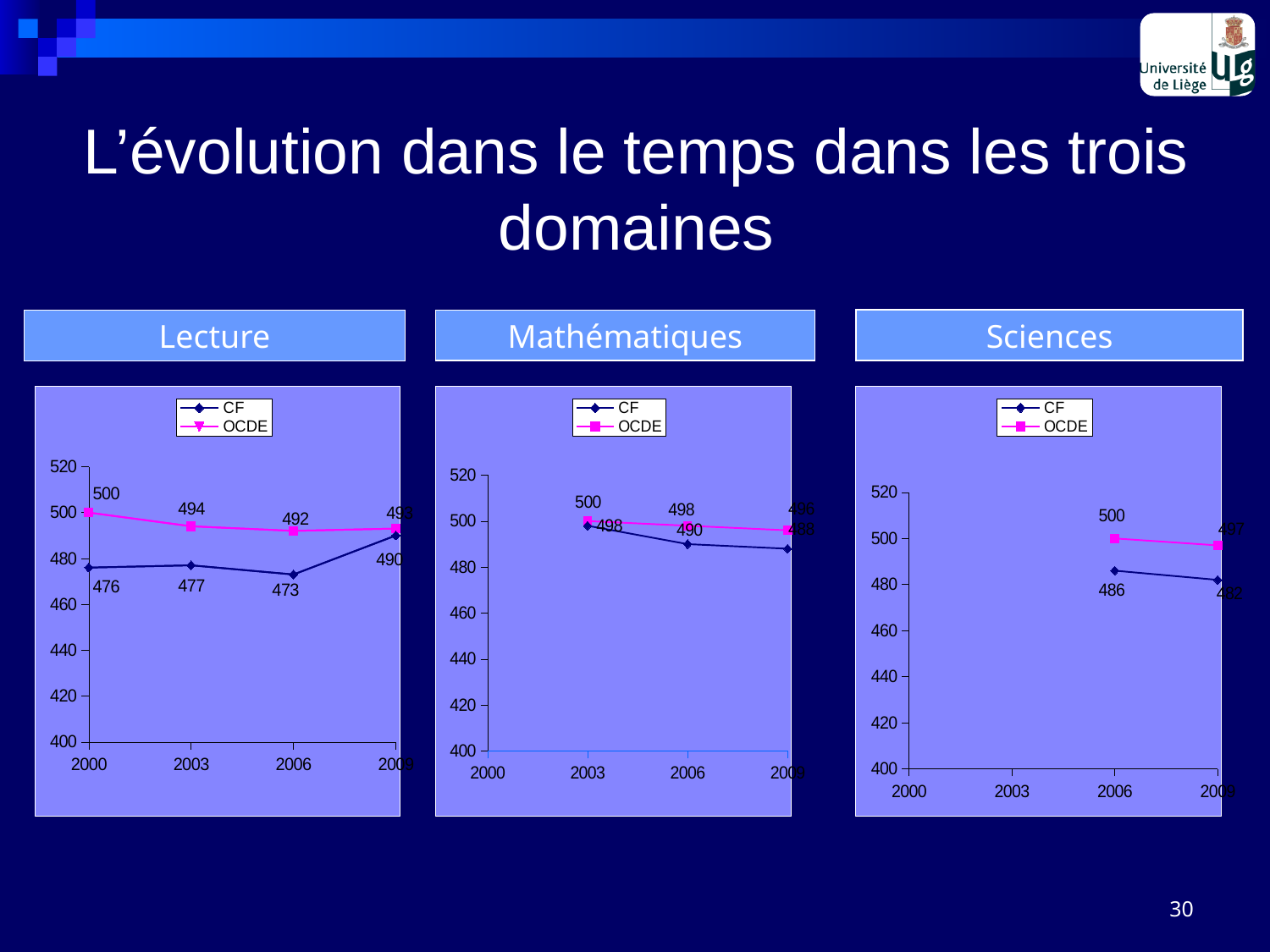
In the Mathématiques chart, what is the CF value for 2006? 490 In the Sciences chart, what is the CF value for 2006? 486 In the Lecture chart, does the CF value rise or fall between 2006 and 2009? rise In the Mathématiques chart, what is the difference between the OCDE and CF values in 2003? 2 In the Mathématiques chart, does the CF line rise or fall from 2003 to 2009? fall In the Lecture chart, in which year is the CF value lowest? 2006 In the Lecture chart, what is the difference between the OCDE and CF values in 2000? 24 In the Mathématiques chart, what is the OCDE value for 2003? 500 How many series does the legend of the Lecture chart list? 2 In the Lecture chart, what is the CF value for 2000? 476 In the Sciences chart, which series has the higher value in 2006, CF or OCDE? OCDE In the Lecture chart, what is the OCDE value for 2003? 494